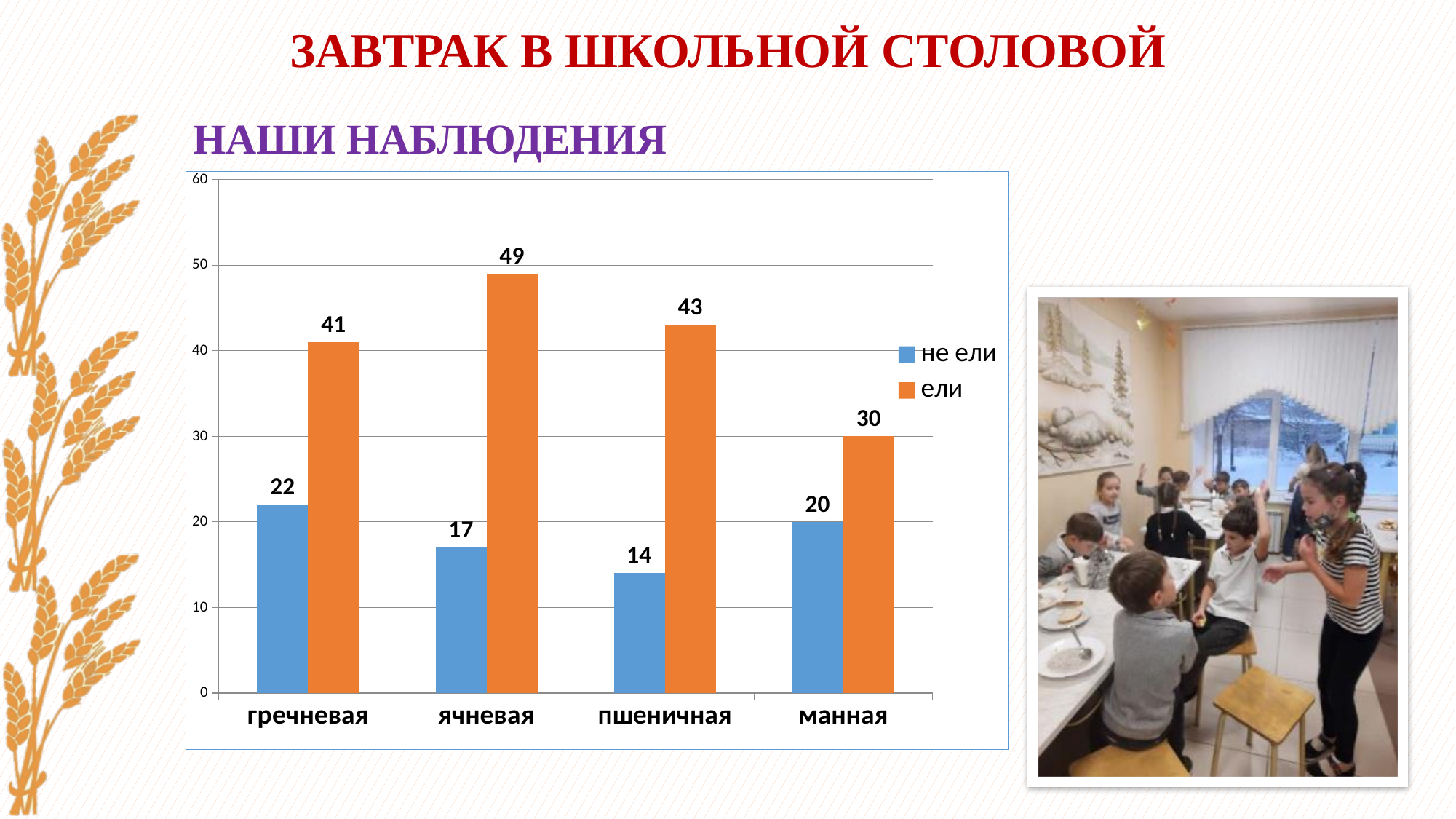
Which colour represents the "ели" series? orange What is the difference between "ели" and "не ели" for ячневая? 32 Which is larger: "не ели" for гречневая or "не ели" for манная? гречневая Is the value for "ели" for пшеничная greater or less than 40? greater What kind of chart is shown on the slide? bar chart What is the value for "не ели" for пшеничная? 14 What is the value for "ели" for манная? 30 Which category has the highest value for "ели"? ячневая Which category has the lowest value for "не ели"? пшеничная How many categories are shown on the x axis? 4 What is the value for "ели" for гречневая? 41 How many series does the legend list? 2